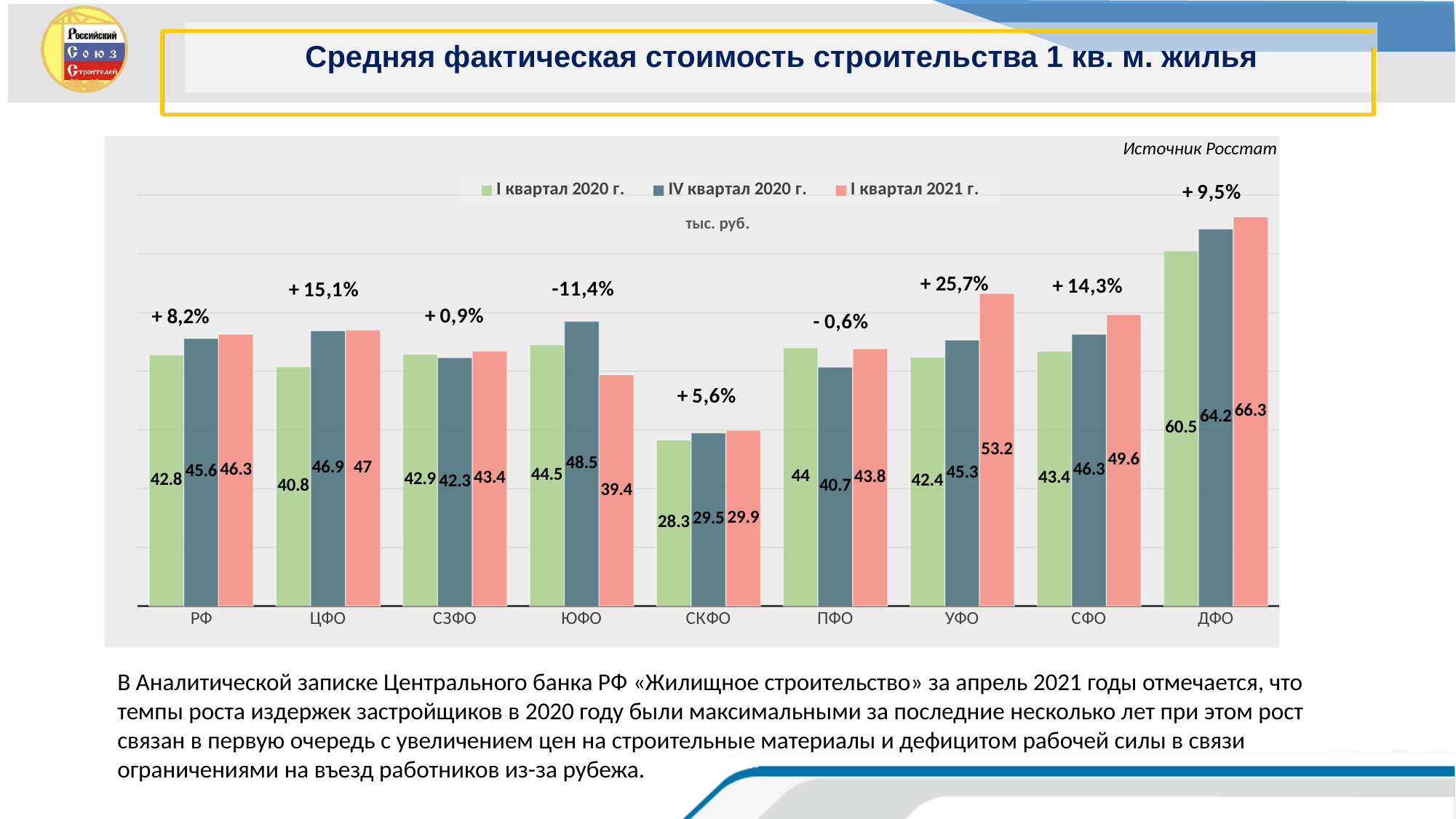
How many categories (regions) are shown on the x axis? 9 What percentage change is annotated above the bars for ЦФО? + 15,1% How many series does the legend list? 3 Which region has the lowest value in IV квартал 2020 г.? СКФО What unit is stated under the legend of the chart? тыс. руб. Which region has the highest value in I квартал 2021 г.? ДФО What is the difference between the I квартал 2021 г. and I квартал 2020 г. values for УФО? 10.8 What is the value for УФО in IV квартал 2020 г.? 45.3 What is the value for СКФО in I квартал 2020 г.? 28.3 What type of chart is shown on the slide? bar chart Which is larger for ЮФО: the IV квартал 2020 г. value or the I квартал 2021 г. value? IV квартал 2020 г. What is the value for ДФО in I квартал 2021 г.? 66.3